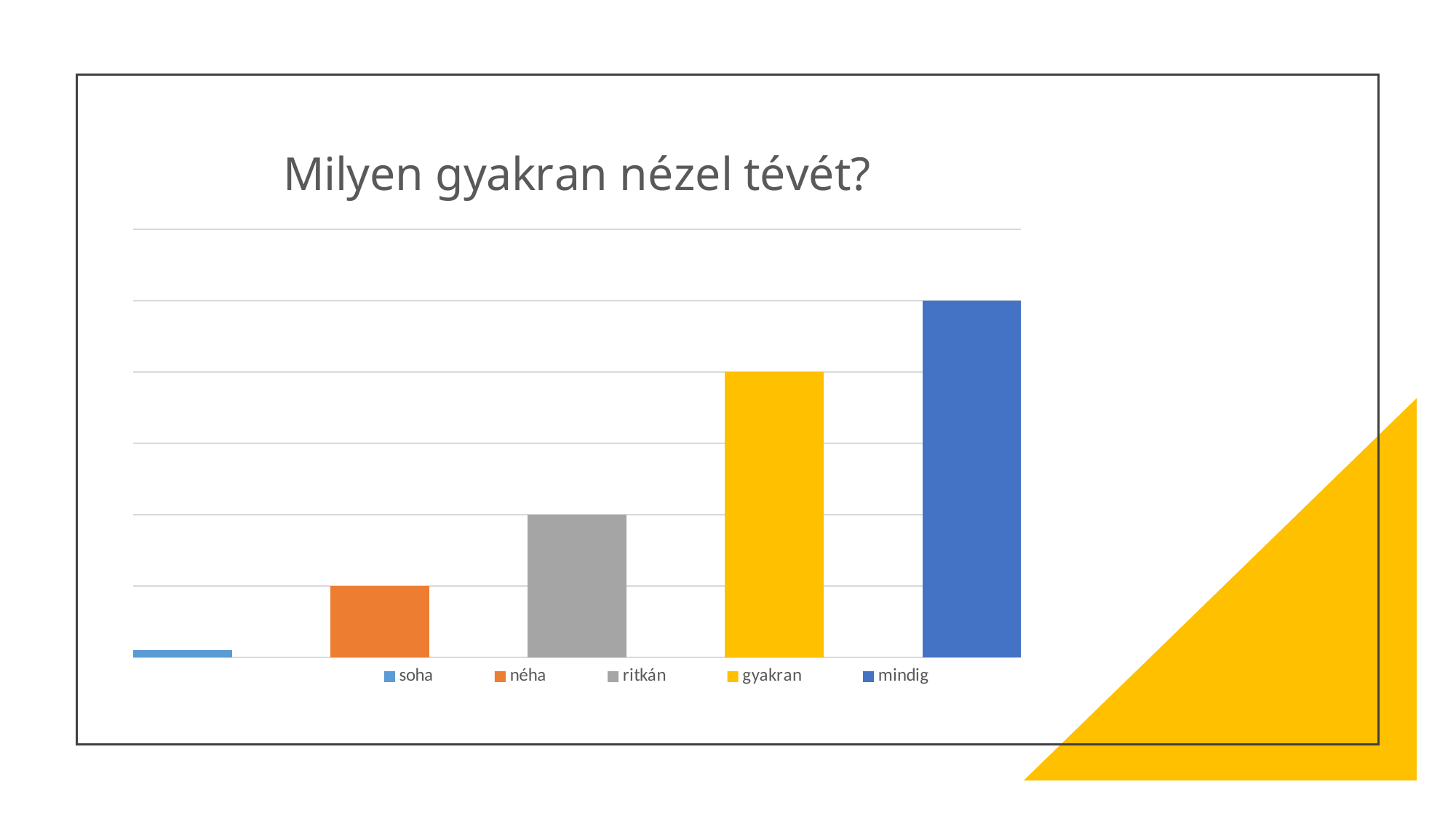
Which category has the highest bar? mindig What colour is the bar for gyakran? yellow Do the bar values rise or fall from left to right across the chart? rise Which category has the lowest bar? soha How many bars are plotted in the chart? 5 Which is larger, the value for gyakran or the value for ritkán? gyakran Which is larger, the value for mindig or the value for gyakran? mindig What is the title of the chart? Milyen gyakran nézel tévét? How many entries does the legend list? 5 What kind of chart is shown on the slide? bar chart Which is larger, the value for néha or the value for soha? néha